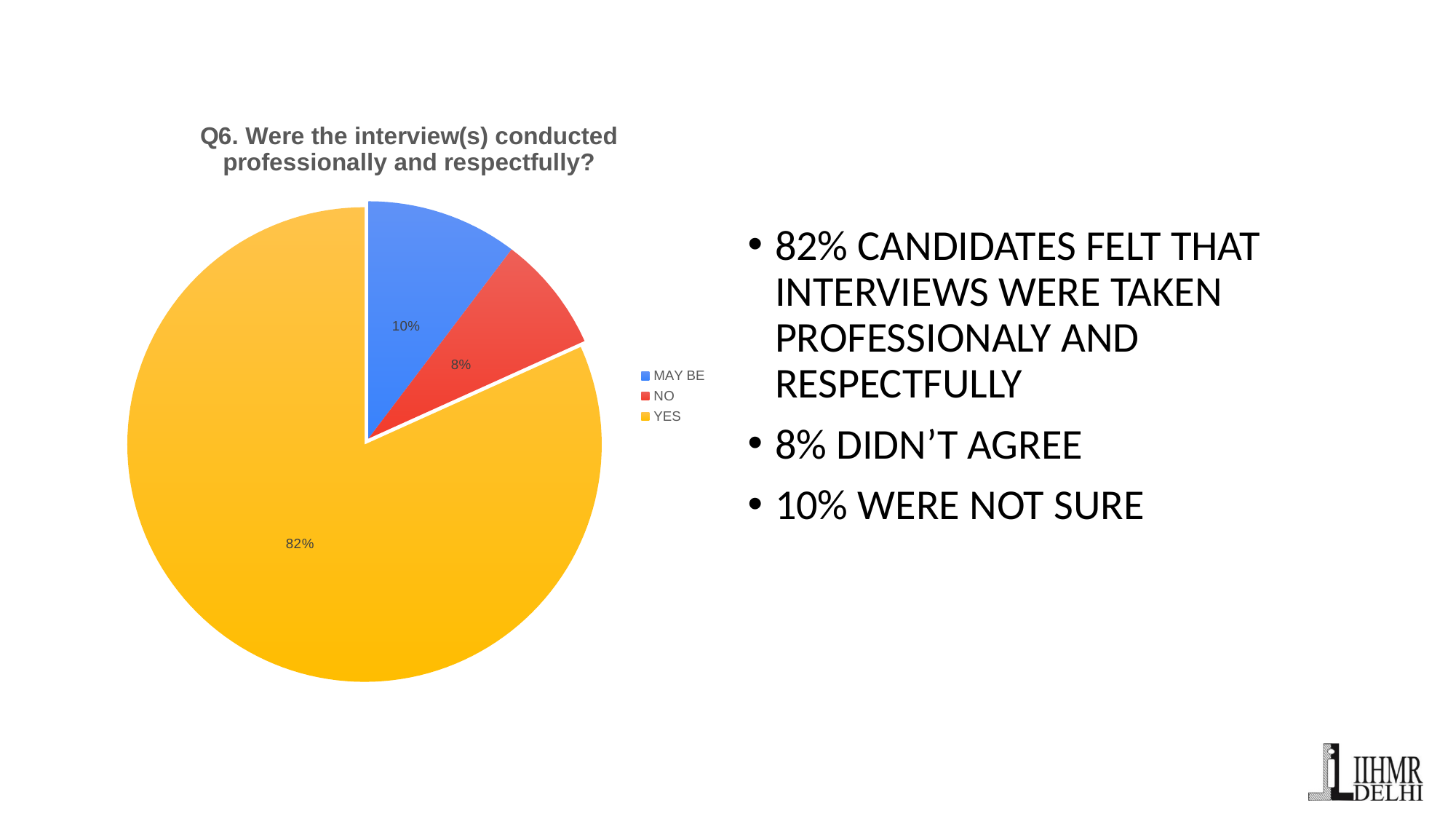
Which category has the largest slice of the pie? YES What kind of chart is shown on the slide? pie chart What share of the pie is labelled MAY BE? 10% What share of the pie is labelled NO? 8% Which category has the smallest slice of the pie? NO What share of the pie is labelled YES? 82% What is the title of the chart? Q6. Were the interview(s) conducted professionally and respectfully? Which slice is larger, MAY BE or NO? MAY BE What is the difference in percentage points between the YES slice and the MAY BE slice? 72 How many entries does the legend list? 3 What colour is the YES slice in the pie chart? yellow How many categories does the pie chart show? 3